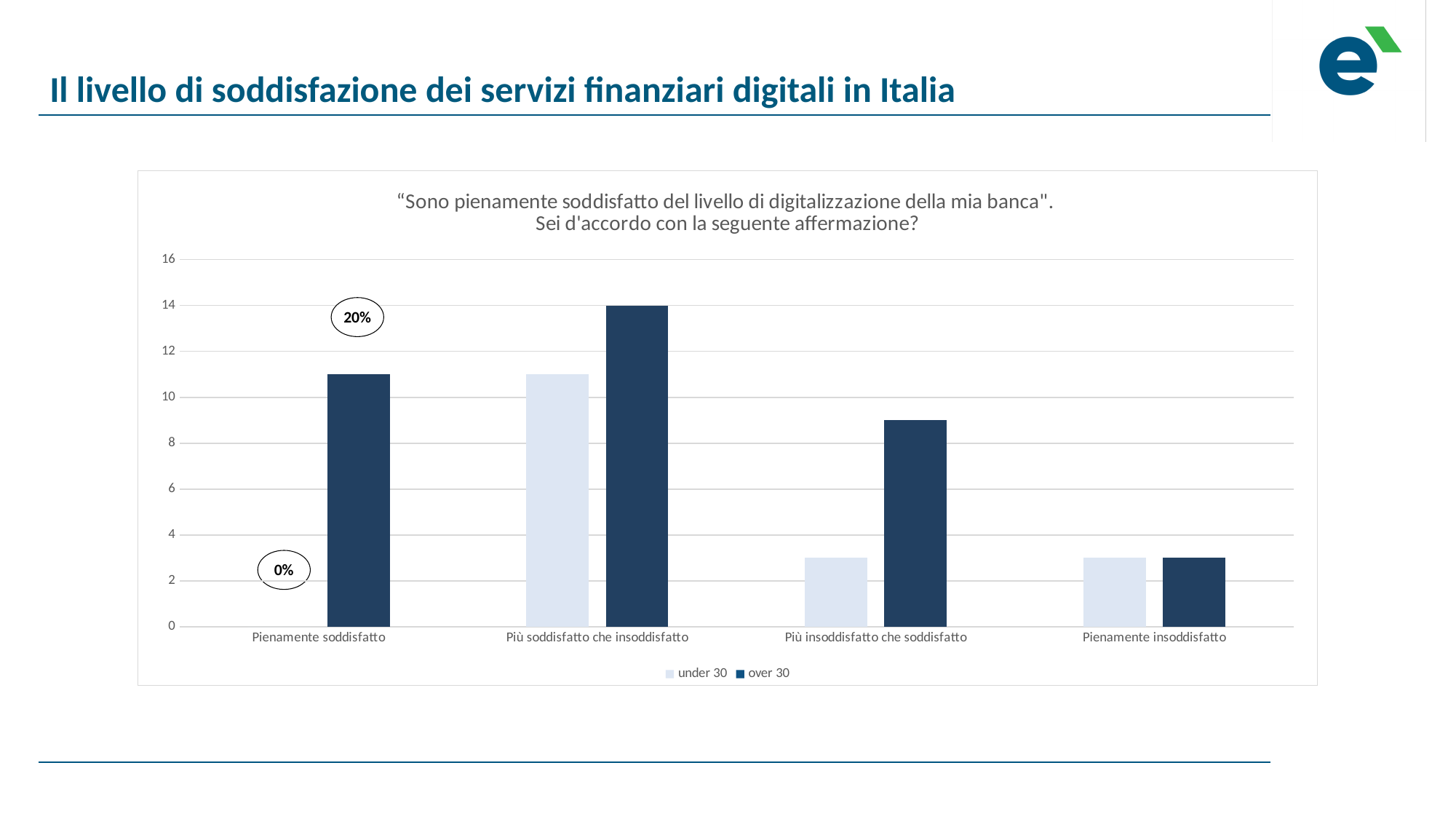
What are the two entries in the chart legend? under 30, over 30 Is the 'over 30' value for 'Pienamente soddisfatto' greater or less than 10? greater How many categories are shown on the x axis? 4 What percentage is written in the circled label next to the 'over 30' bar for 'Pienamente soddisfatto'? 20% Which category has the lowest 'over 30' value? Pienamente insoddisfatto What kind of chart is shown on the slide? bar chart In the 'Pienamente soddisfatto' category, which series has the larger value, 'under 30' or 'over 30'? over 30 How many series does the legend list? 2 Which category has the highest 'over 30' value? Più soddisfatto che insoddisfatto What is the value for 'over 30' in the 'Più soddisfatto che insoddisfatto' category? 14 Is the 'under 30' value for 'Più insoddisfatto che soddisfatto' greater or less than 4? less Which category has the highest 'under 30' value? Più soddisfatto che insoddisfatto